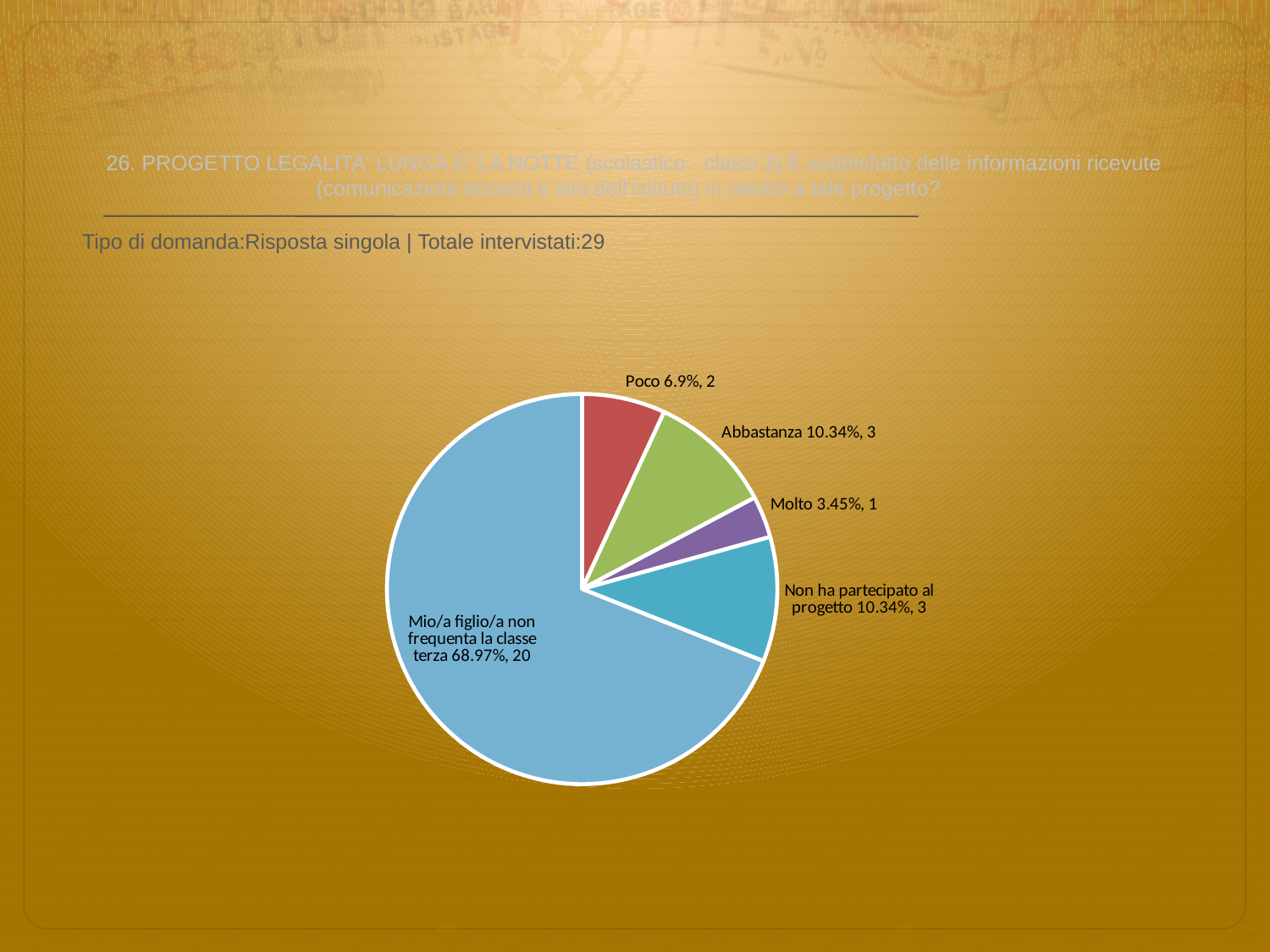
What percentage share does the 'Molto' slice have? 3.45% How many slices does the pie chart have? 5 Which category has the smallest slice? Molto Which has more respondents, 'Poco' or 'Molto'? Poco What is the total number of respondents (Totale intervistati) stated on the slide? 29 How many respondents chose 'Abbastanza'? 3 Which category has the largest slice? Mio/a figlio/a non frequenta la classe terza What kind of chart is shown on the slide? pie chart What percentage share does the 'Mio/a figlio/a non frequenta la classe terza' slice have? 68.97% What percentage share does the 'Poco' slice have? 6.9% What is the difference in respondent count between 'Mio/a figlio/a non frequenta la classe terza' and 'Poco'? 18 How many respondents are in the 'Non ha partecipato al progetto' slice? 3